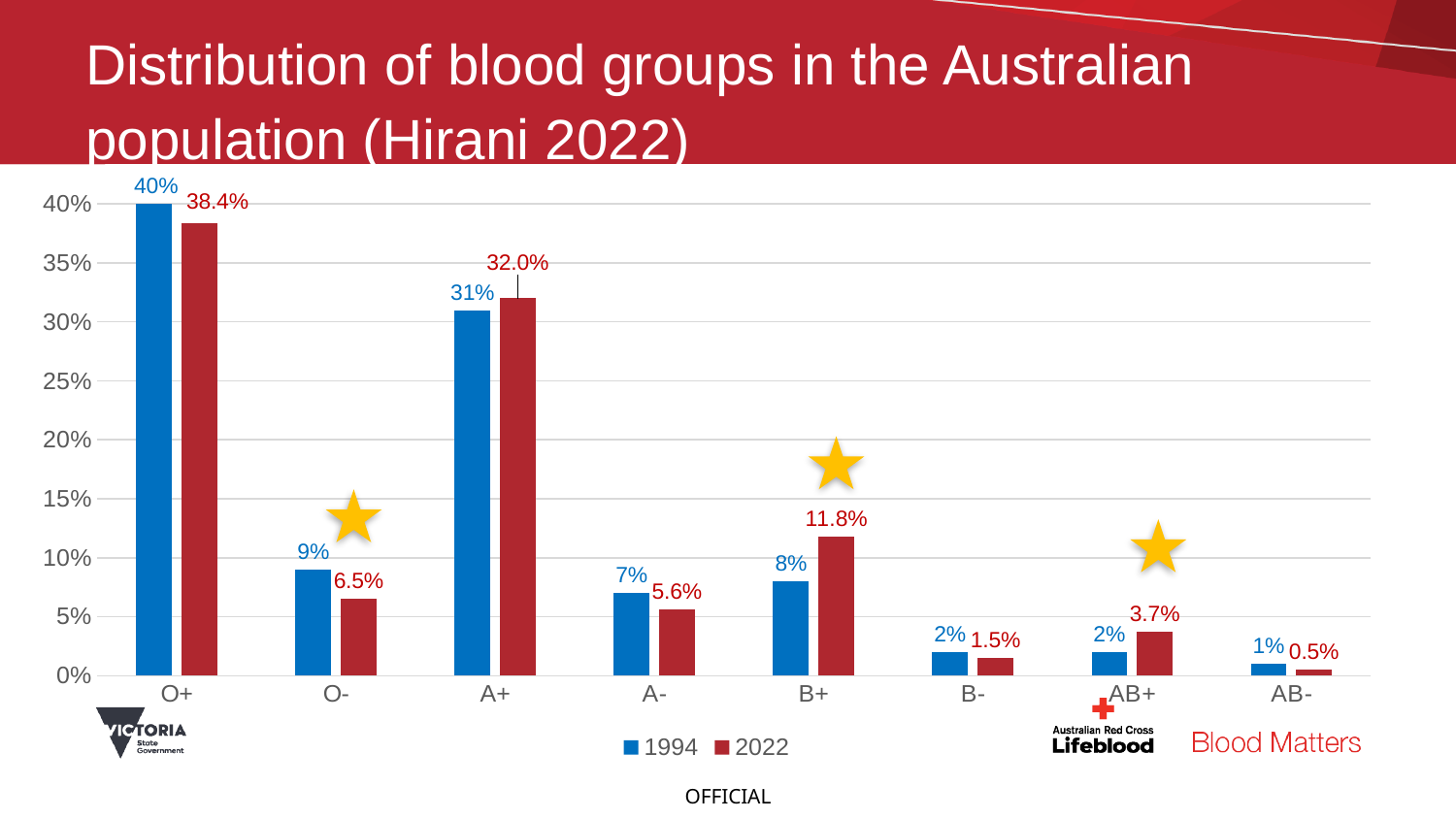
What is the difference between the 1994 and 2022 values for blood group O-? 2.5% What is the 2022 value for blood group B+? 11.8% Is the 2022 value for blood group A+ greater or less than 30%? greater What kind of chart is shown on the slide? Bar chart Which series is shown in red in the legend? 2022 Which blood group has the lowest 1994 value? AB- What is the 1994 value for blood group A+? 31% What is the 2022 value for blood group O+? 38.4% How many blood groups are shown on the x axis? 8 Which blood group has the highest 2022 value? O+ How many series does the legend list? 2 Which is larger for blood group B+: the 1994 value or the 2022 value? 2022